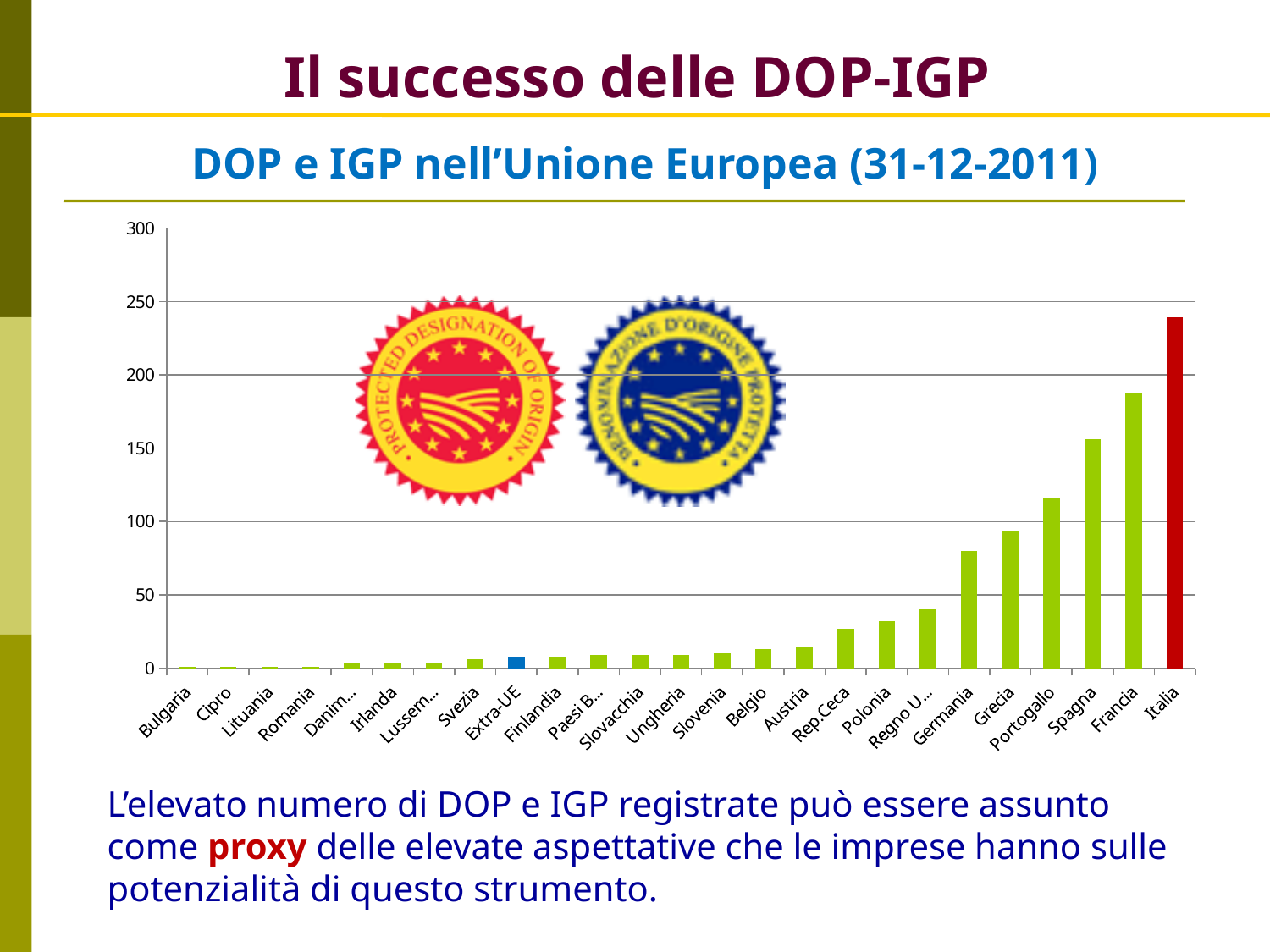
Is the value for Portogallo greater or less than 100? greater Do the values rise or fall moving from left to right along the x axis? rise Which has a larger value, Francia or Spagna? Francia Which country has the highest number of DOP and IGP in the chart? Italia What is the title of the chart? DOP e IGP nell'Unione Europea (31-12-2011) Which has a larger value, Germania or Grecia? Grecia Is the value for Francia greater or less than 200? less Is the value for Italia greater or less than 200? greater What kind of chart is shown on the slide? bar chart